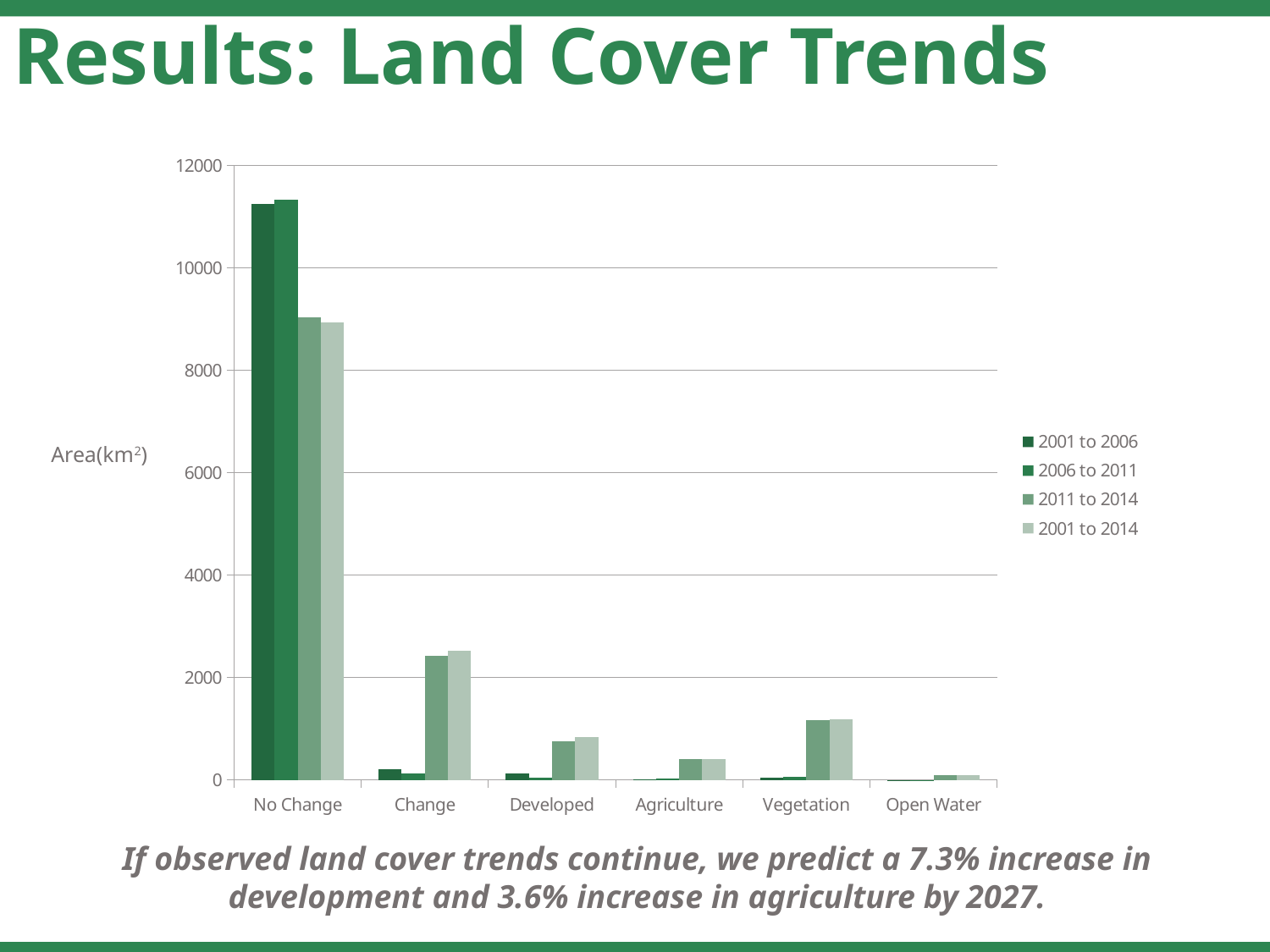
How many series does the chart's legend list? 4 Which category has the lowest value for the 2011 to 2014 series? Open Water How many land cover categories are shown on the x axis of the chart? 6 For the 2011 to 2014 series, which is larger: Change or Vegetation? Change What kind of chart is shown on the slide? Bar chart Is the value for Change in the 2011 to 2014 series greater or less than 2000? greater Is the value for No Change in the 2011 to 2014 series greater or less than 10000? less Is the value for No Change in the 2001 to 2006 series greater or less than 10000? greater Which category has the highest value for the 2001 to 2006 series? No Change What is the label on the chart's vertical axis? Area(km²) For No Change, which is larger: the 2001 to 2006 value or the 2011 to 2014 value? 2001 to 2006